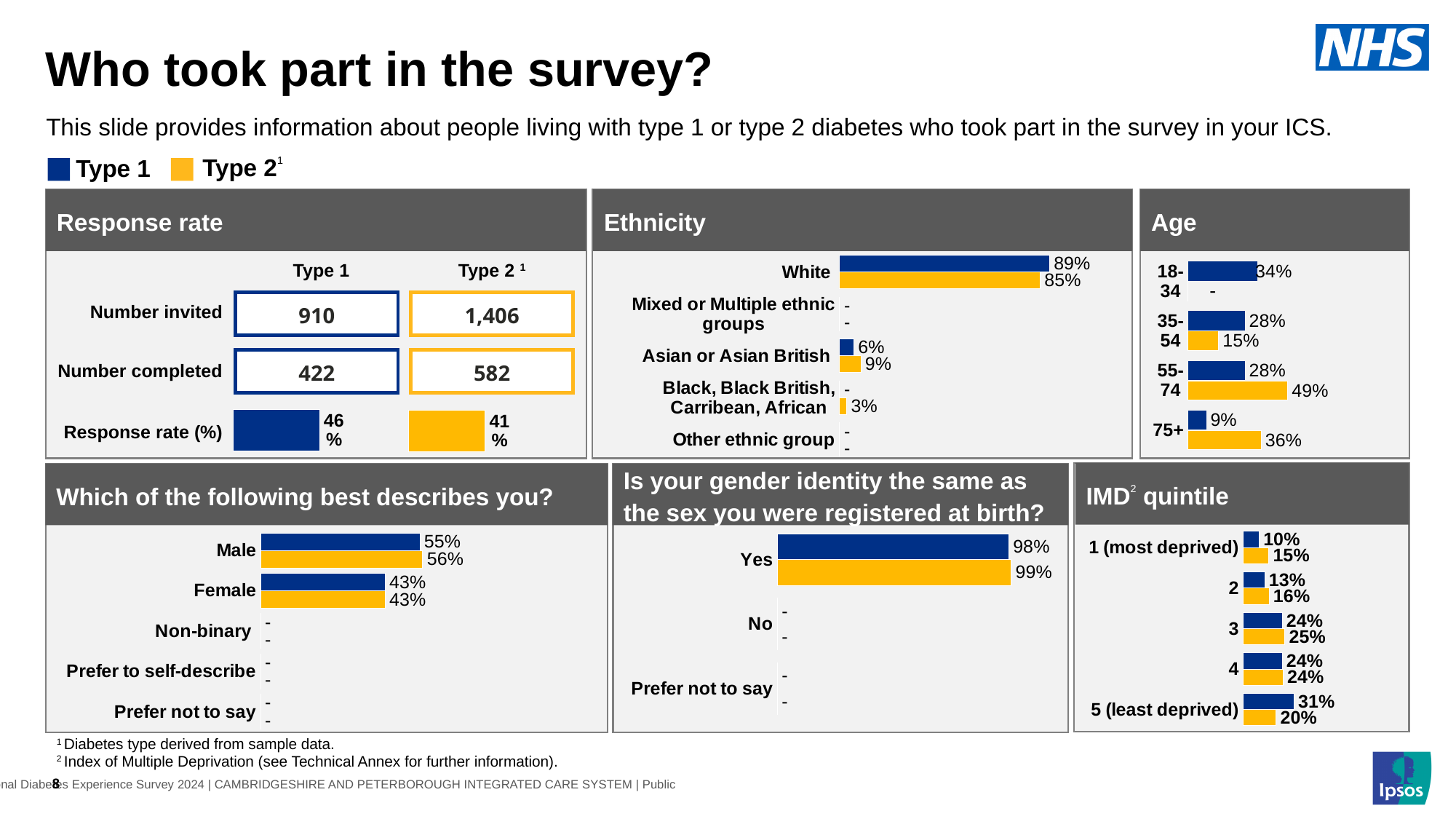
In the 'Which of the following best describes you?' chart, what is the Type 1 value for Male? 55% In the Response rate chart, what is the response rate for Type 1? 46% In the Ethnicity chart, what is the Type 2 value for Asian or Asian British? 9% In the gender identity chart, what is the Type 2 value for Yes? 99% In the IMD quintile chart, which quintile has the lowest Type 1 value? 1 (most deprived) In the Age chart, what is the Type 2 value for the 55-74 age group? 49% How many series does the legend at the top of the slide list? 2 In the IMD quintile chart, what is the Type 1 value for 5 (least deprived)? 31% In the IMD quintile chart, which is larger for quintile 5 (least deprived): the Type 1 value or the Type 2 value? Type 1 In the Age chart, what is the difference between the Type 2 and Type 1 values for the 75+ age group? 27 percentage points In the Ethnicity chart, what is the Type 1 value for White? 89% In the Age chart, which age group has the highest Type 1 value? 18-34